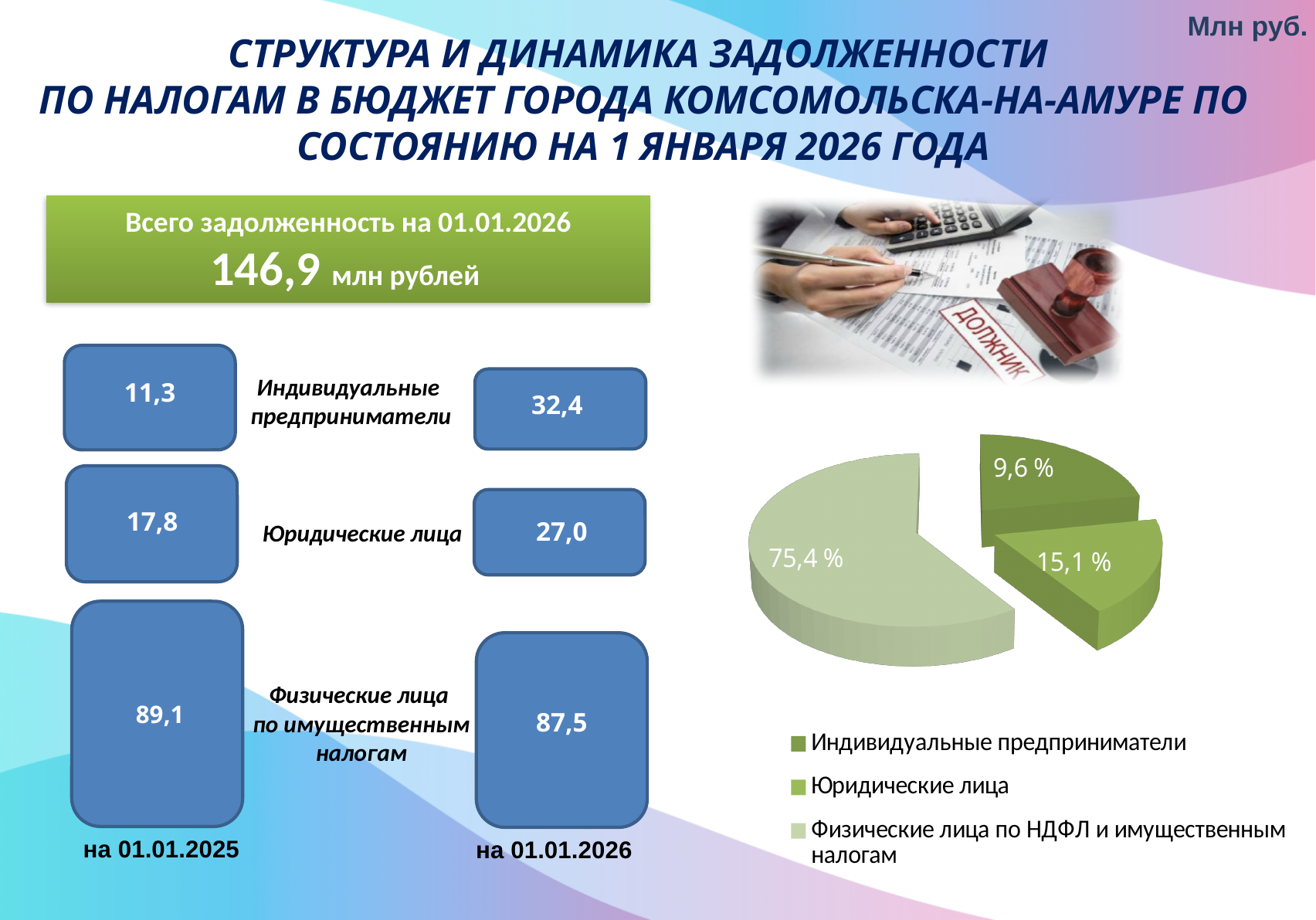
How many slices does the pie chart have? 3 Which category has the largest slice in the pie chart? Физические лица по НДФЛ и имущественным налогам In the pie chart, what share is shown for Юридические лица? 15,1 % Which category has the smallest slice in the pie chart? Индивидуальные предприниматели In the pie chart, by how many percentage points does the share for Юридические лица exceed the share for Индивидуальные предприниматели? 5,5 % In the pie chart, what is the difference between the share for Физические лица по НДФЛ и имущественным налогам and the share for Юридические лица? 60,3 % How many entries does the legend of the pie chart list? 3 In the pie chart, what share is shown for Индивидуальные предприниматели? 9,6 % In the pie chart, which legend entry is shown in the lightest green colour? Физические лица по НДФЛ и имущественным налогам In the pie chart, what share is shown for Физические лица по НДФЛ и имущественным налогам? 75,4 % In the pie chart, which is larger: the share for Юридические лица or the share for Индивидуальные предприниматели? Юридические лица What kind of chart is shown on the right side of the slide? pie chart